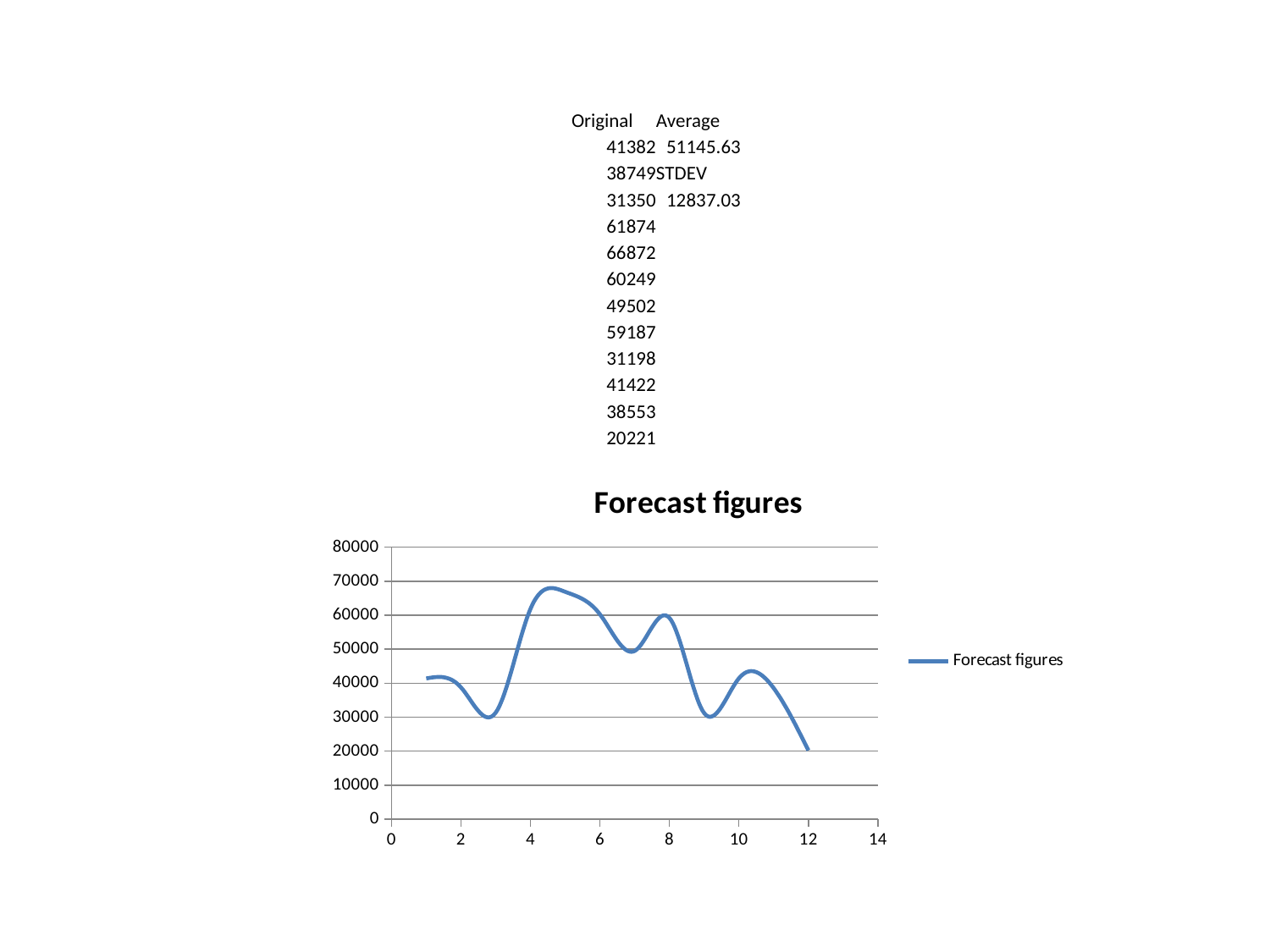
What is the title of the chart? Forecast figures At which x value does the Forecast figures line reach its highest point? 5 At which x value does the Forecast figures line reach its lowest point? 12 Does the Forecast figures line rise or fall between x = 10 and x = 12? fall What is the name of the series shown in the chart legend? Forecast figures What kind of chart is shown under the title "Forecast figures"? line chart How many series does the chart legend list? 1 Is the value of the Forecast figures line at x = 12 greater or less than 30000? less Is the value of the Forecast figures line at x = 8 greater or less than 50000? greater Is the value of the Forecast figures line at x = 3 greater or less than 40000? less Which is larger on the Forecast figures line: the value at x = 5 or the value at x = 8? x = 5